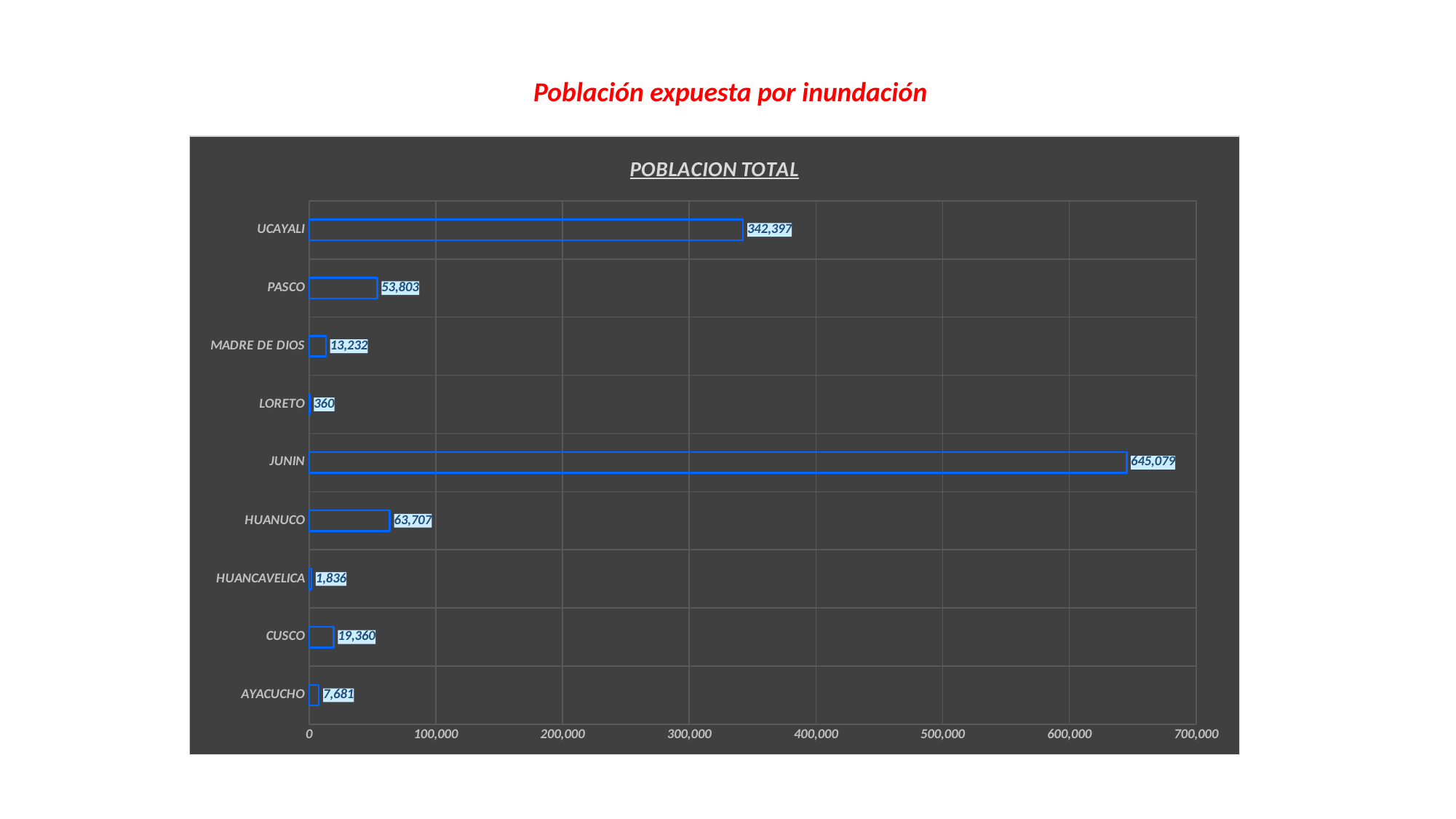
What is the value for JUNIN? 645,079 What is the difference between the values for JUNIN and UCAYALI? 302,682 What is the title of the chart? POBLACION TOTAL What is the value for HUANCAVELICA? 1,836 What is the value for UCAYALI? 342,397 How many categories are shown in the chart? 9 Which category has the lowest value? LORETO What kind of chart is shown on the slide? bar chart What is the value for MADRE DE DIOS? 13,232 Is the value for UCAYALI greater or less than 300,000? greater Which category has the highest value? JUNIN Which is larger, the value for HUANUCO or the value for PASCO? HUANUCO